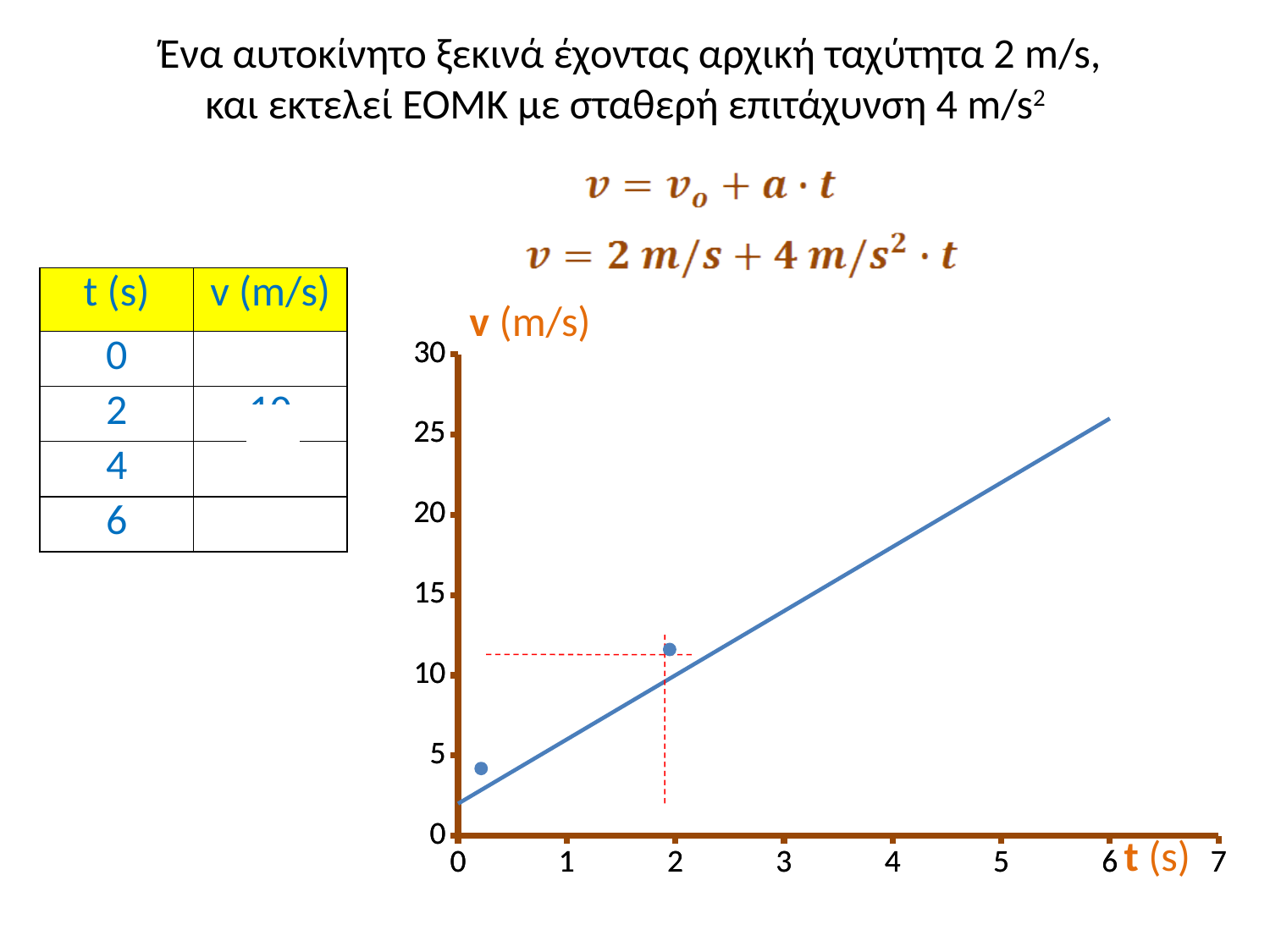
Is the value of v at t = 6 greater or less than the value at t = 1? greater Is the value of v at t = 3 greater or less than 10? greater Is the value of v at t = 4 greater or less than 20? less Is the value of v at t = 6 greater or less than 20? greater What is the label of the vertical axis of the chart? v (m/s) Does the plotted line rise or fall as t increases along the x axis? rise What is the label of the horizontal axis of the chart? t (s) What kind of chart is shown on the slide? line chart